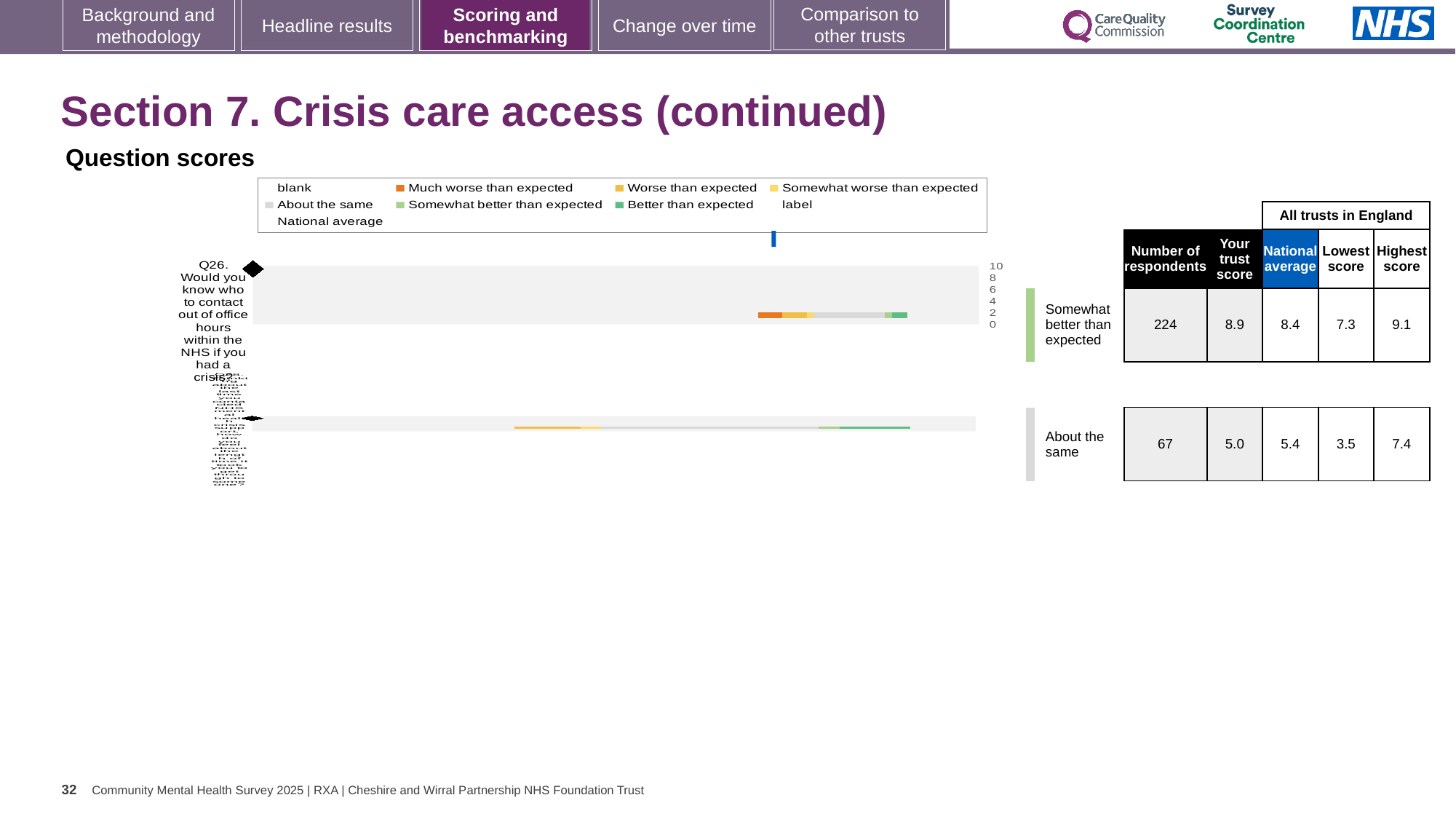
What is the highest score among all trusts in England for Q26? 9.1 What is the lowest score among all trusts in England for Q26? 7.3 For Q26, what is the difference between the highest and lowest scores across all trusts in England? 1.8 What is the national average score for Q26? 8.4 What kind of chart is shown on the slide? Bar chart For Q26, which is larger: the trust score or the national average? The trust score (8.9) How many respondents answered Q26? 224 What benchmark category is Q26 rated as? Somewhat better than expected How many questions are plotted in the chart? 2 What is the trust score for the second question row, which is rated 'About the same'? 5.0 What is the trust score for Q26 (Would you know who to contact out of office hours within the NHS if you had a crisis?)? 8.9 For Q26, how much higher is the trust score than the national average? 0.5